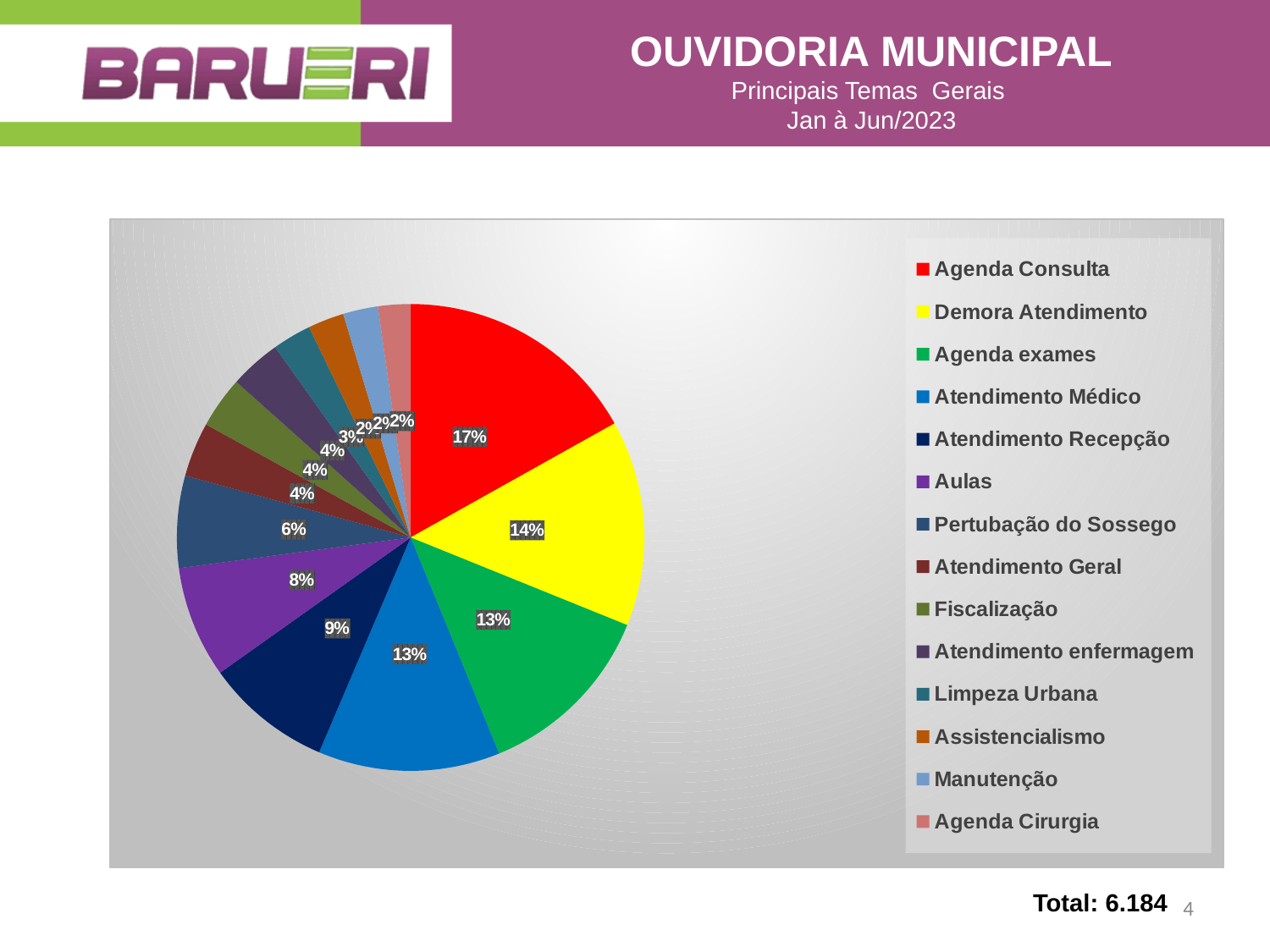
What is the value shown for Atendimento Recepção? 9% What colour is the slice for Demora Atendimento? yellow What share of the pie does Agenda Consulta represent? 17% What is the value shown for Agenda exames? 13% What is the value shown for Pertubação do Sossego? 6% How many categories does the legend list? 14 Which category has the largest slice of the pie? Agenda Consulta What share of the pie does Demora Atendimento represent? 14% Which is larger, the slice for Aulas or the slice for Atendimento Recepção? Atendimento Recepção What kind of chart is shown on the slide? pie chart What is the difference between the shares of Agenda Consulta and Demora Atendimento? 3% What is the value shown for Aulas? 8%